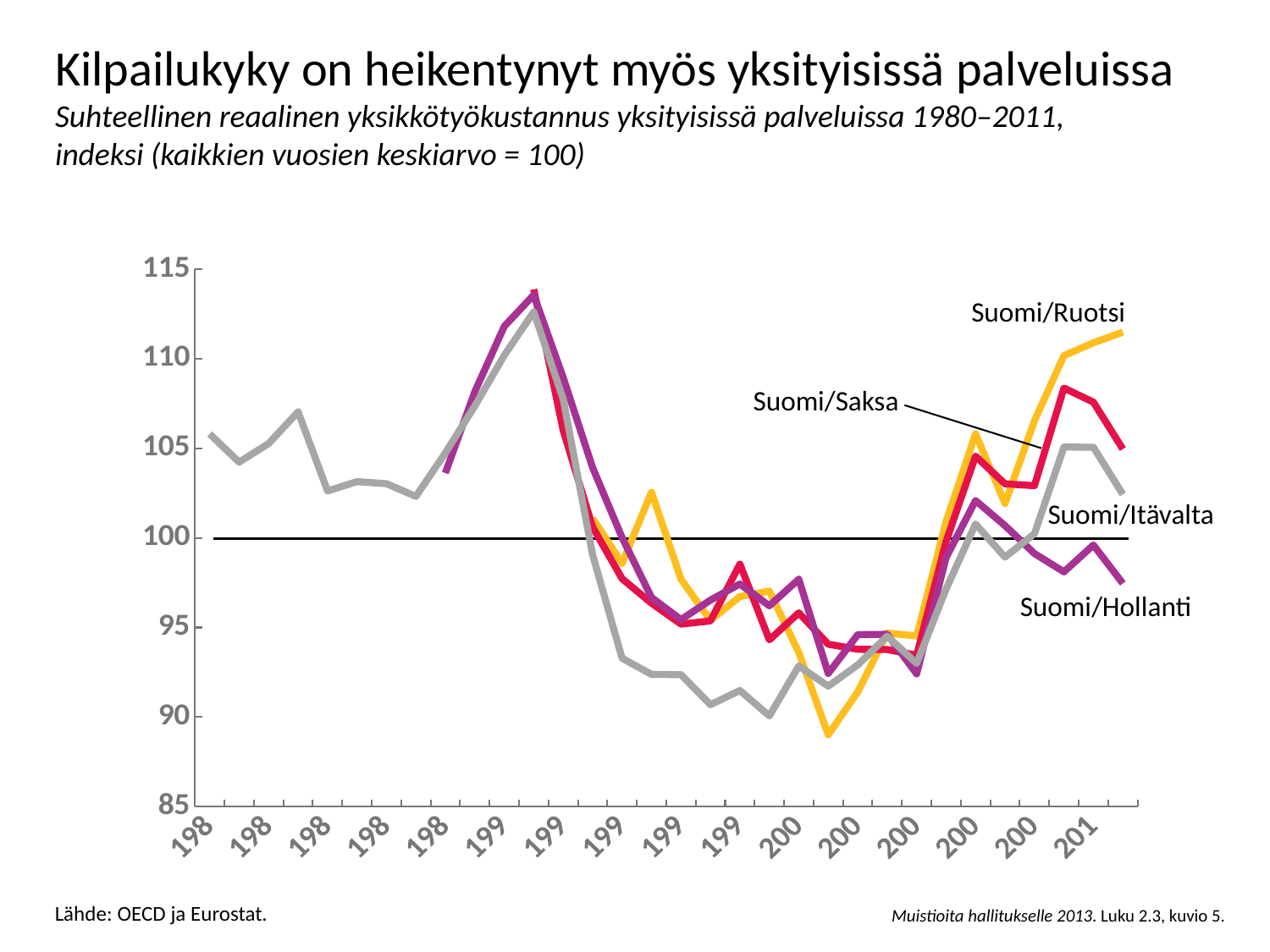
At the right-hand end of the chart, is the value for Suomi/Ruotsi greater or less than 110? greater Which series has the highest value at the right-hand end of the chart? Suomi/Ruotsi What kind of chart is shown on the slide? line chart Is the lowest point of the Suomi/Ruotsi line greater or less than 90? less How many series are plotted on the chart? 4 Over the last few years shown, does the Suomi/Ruotsi line rise or fall? rise Is the highest point of the Suomi/Saksa line greater or less than 110? greater At the right-hand end of the chart, which is larger: Suomi/Saksa or Suomi/Hollanti? Suomi/Saksa At what value is the horizontal reference line drawn across the chart? 100 Which series has the lowest value at the right-hand end of the chart? Suomi/Hollanti What is the title of the slide? Kilpailukyky on heikentynyt myös yksityisissä palveluissa